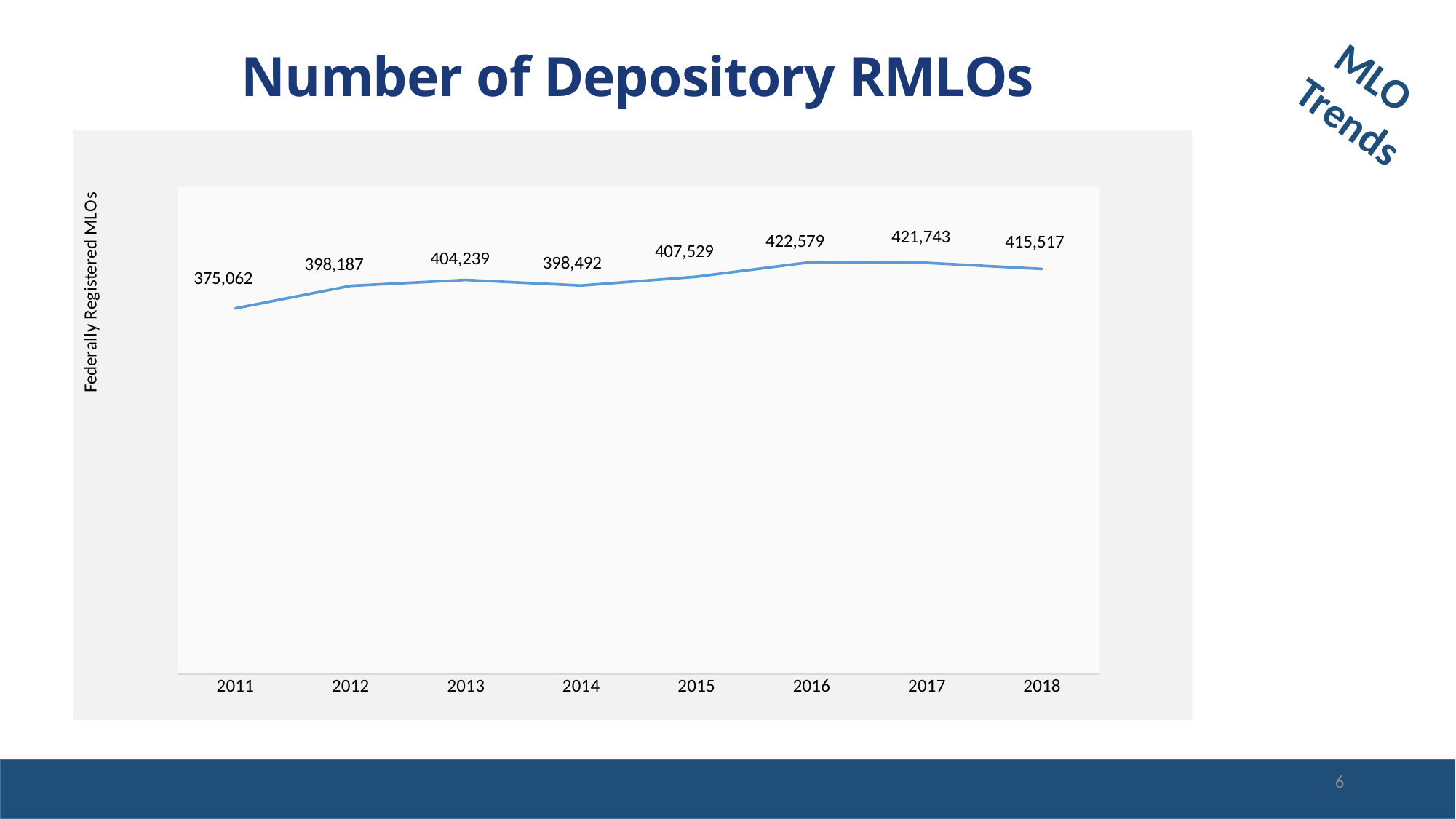
What is the number of depository RMLOs in 2016? 422,579 What is the difference between the number of depository RMLOs in 2016 and in 2011? 47,517 What is the number of depository RMLOs in 2011? 375,062 Which year has the highest number of depository RMLOs? 2016 What is the number of depository RMLOs in 2014? 398,492 Which year has the lowest number of depository RMLOs? 2011 What is the number of depository RMLOs in 2018? 415,517 Which year has more depository RMLOs, 2013 or 2014? 2013 What is the difference between the number of depository RMLOs in 2017 and in 2018? 6,226 What is the label on the vertical axis of the chart? Federally Registered MLOs What kind of chart is shown on the slide? Line chart How many years are shown on the x axis of the chart? 8